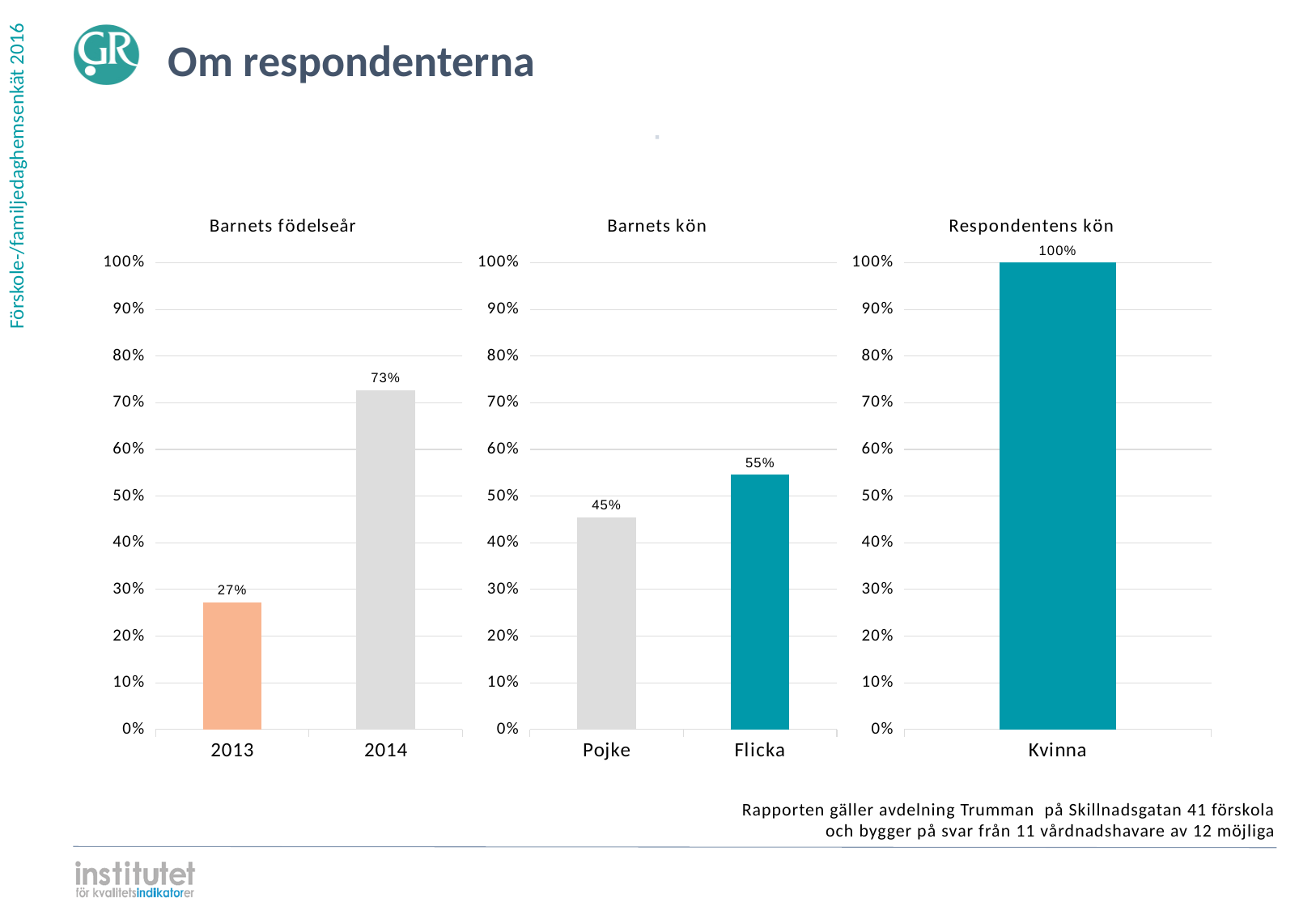
What kind of chart is the 'Barnets kön' chart? Bar chart In the 'Barnets kön' chart, which is larger, Pojke or Flicka? Flicka In the 'Barnets födelseår' chart, what is the difference between the values for 2014 and 2013? 46% In the 'Respondentens kön' chart, what is the value for Kvinna? 100% In the 'Barnets kön' chart, what is the difference between the values for Flicka and Pojke? 10% How many categories are shown in the 'Respondentens kön' chart? 1 In the 'Barnets kön' chart, what is the value for Pojke? 45% In the 'Barnets födelseår' chart, what is the value for 2014? 73% In the 'Barnets kön' chart, what is the value for Flicka? 55% In the 'Barnets födelseår' chart, what is the value for 2013? 27% In the 'Barnets födelseår' chart, which category has the highest value? 2014 In the 'Barnets kön' chart, which category has the lowest value? Pojke